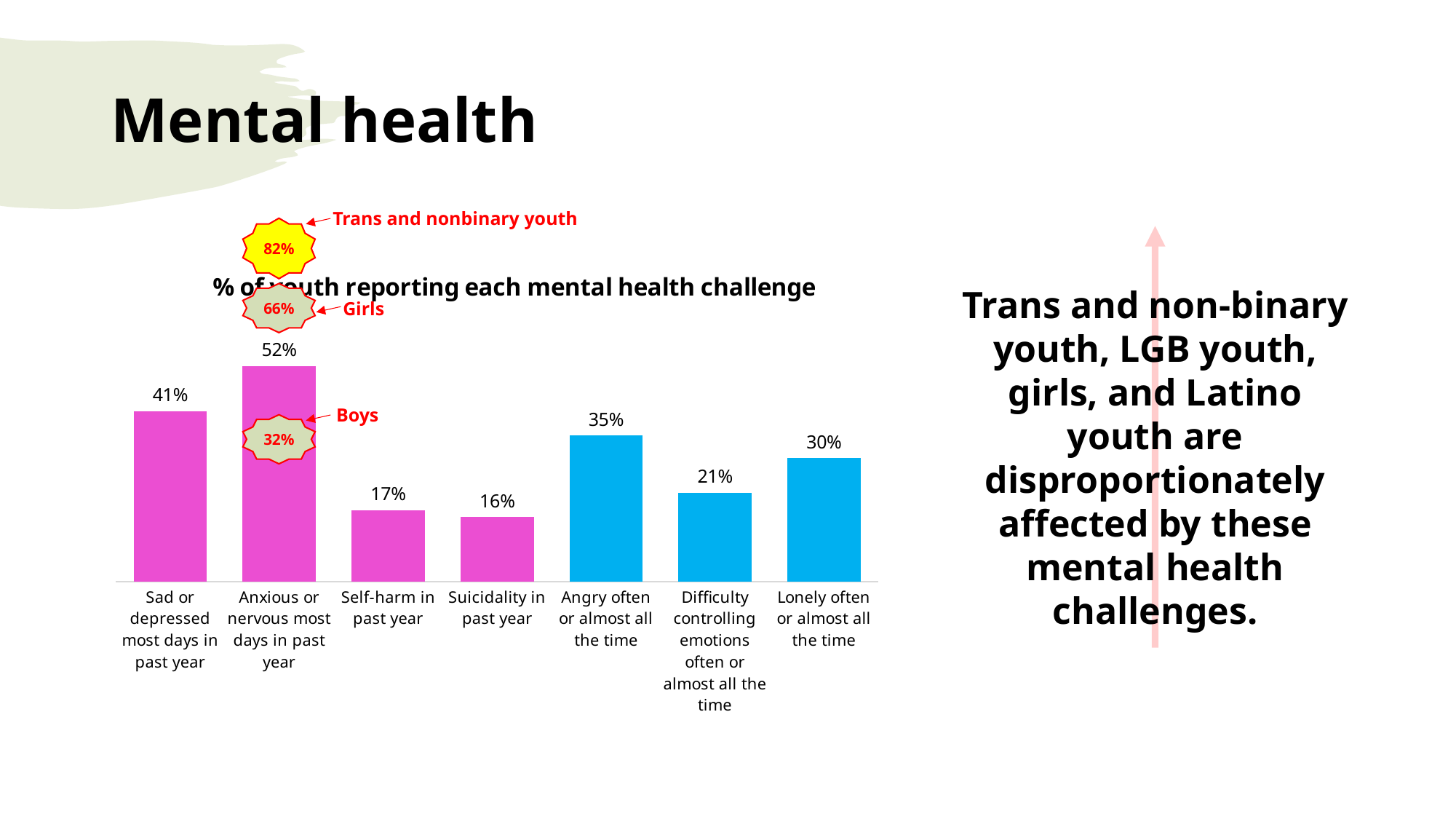
What type of chart is used to show the percentage of youth reporting each mental health challenge? Bar chart How many mental health challenges are shown on the chart? 7 What percentage of youth reported being anxious or nervous most days in the past year? 52% What percentage of youth reported being sad or depressed most days in the past year? 41% What percentage of youth reported being lonely often or almost all the time? 30% Which is larger: the percentage reporting angry often or almost all the time, or the percentage reporting difficulty controlling emotions often or almost all the time? Angry often or almost all the time What is the title of the chart? % of youth reporting each mental health challenge Which mental health challenge has the highest percentage of youth reporting it? Anxious or nervous most days in past year What percentage of youth reported self-harm in the past year? 17% What is the difference between the percentage reporting anxious or nervous most days and the percentage reporting sad or depressed most days? 11% According to the callout, what percentage of trans and nonbinary youth reported being anxious or nervous most days in the past year? 82% Which mental health challenge has the lowest percentage of youth reporting it? Suicidality in past year